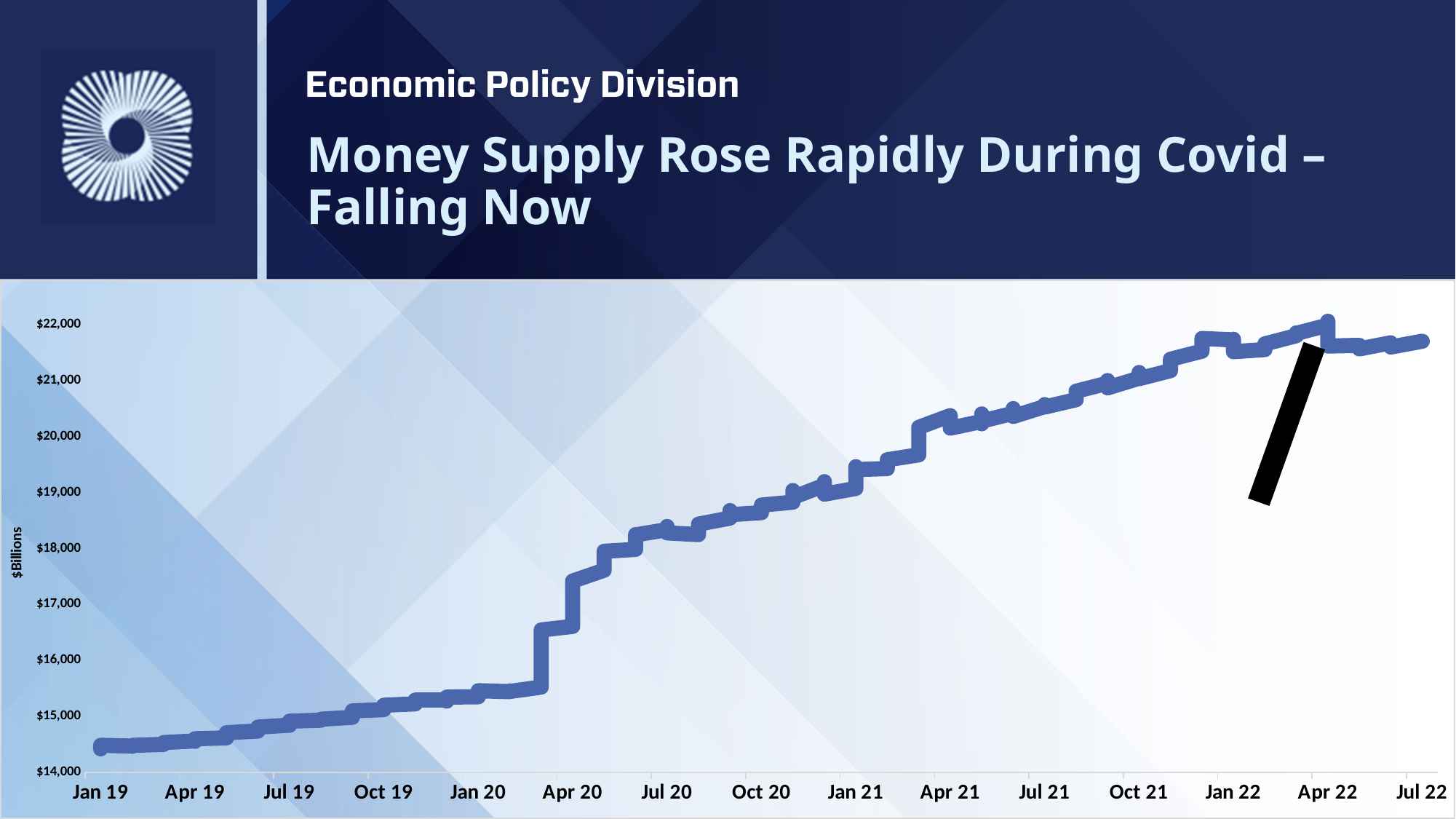
Is the value at Jul 22 greater or less than $22,000? less How many date labels are shown along the x axis? 15 Is the value at Jul 21 greater or less than $20,000? greater Is the value at Apr 20 greater or less than $16,000? greater What kind of chart is shown on the slide? Line chart What is the title of the chart on the slide? Money Supply Rose Rapidly During Covid – Falling Now Overall, do the values rise or fall from Jan 19 to Jul 22? Rise Which is larger, the value at Jan 20 or the value at Apr 20? Apr 20 Which is larger, the value at Jan 19 or the value at Jul 22? Jul 22 What is the label on the vertical axis of the chart? $Billions